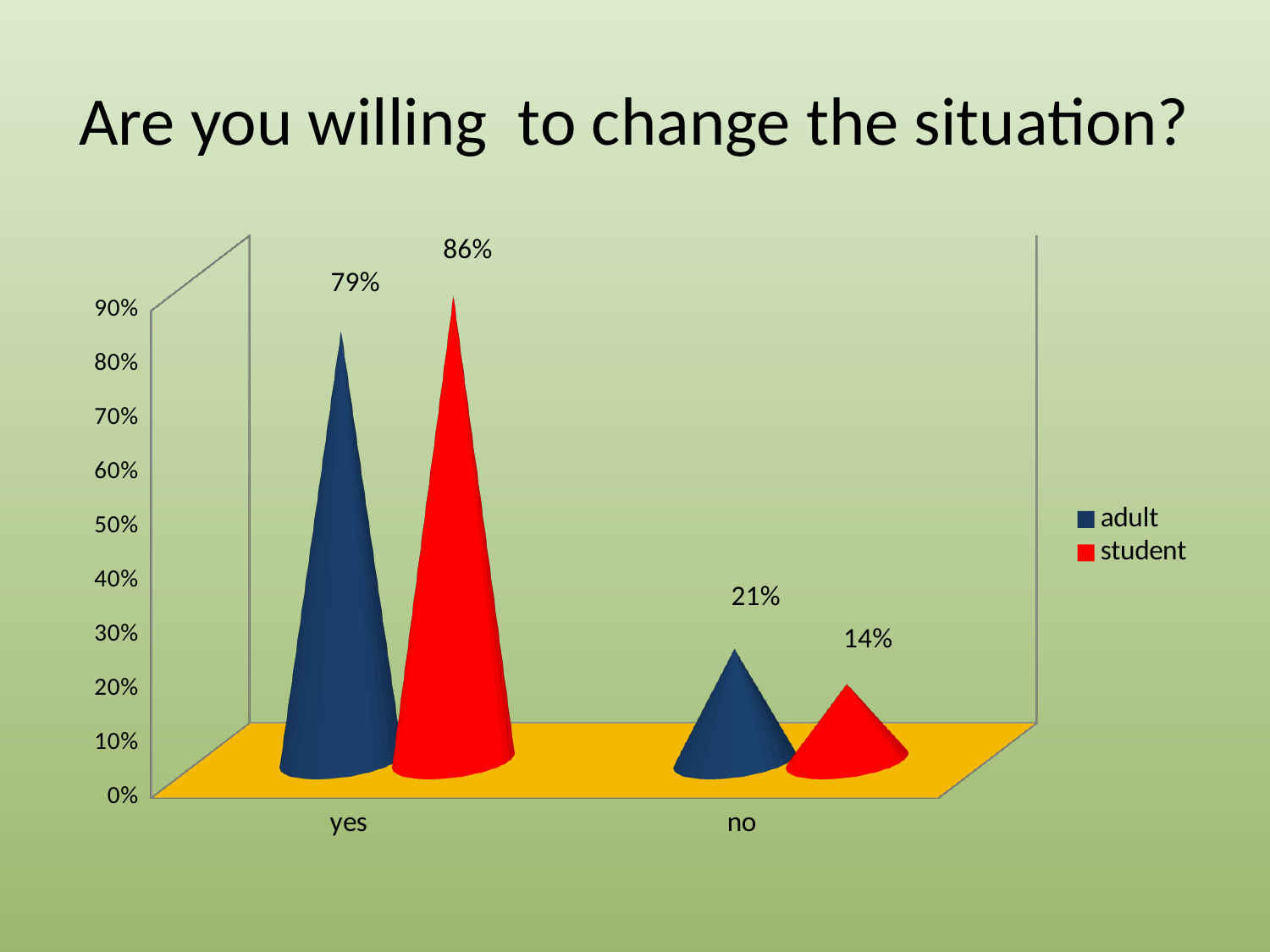
What is the title of the chart? Are you willing to change the situation? How many series does the legend list? 2 What percentage of adults answered "no"? 21% Which group has the higher value for "yes", adult or student? student What percentage of students answered "no"? 14% What is the difference between the adult and student values for "no"? 7% Which answer category has the lowest value for students? no What percentage of adults answered "yes"? 79% Which group has the higher value for "no", adult or student? adult How many answer categories are shown on the x axis? 2 What is the difference between the student and adult values for "yes"? 7% What percentage of students answered "yes"? 86%